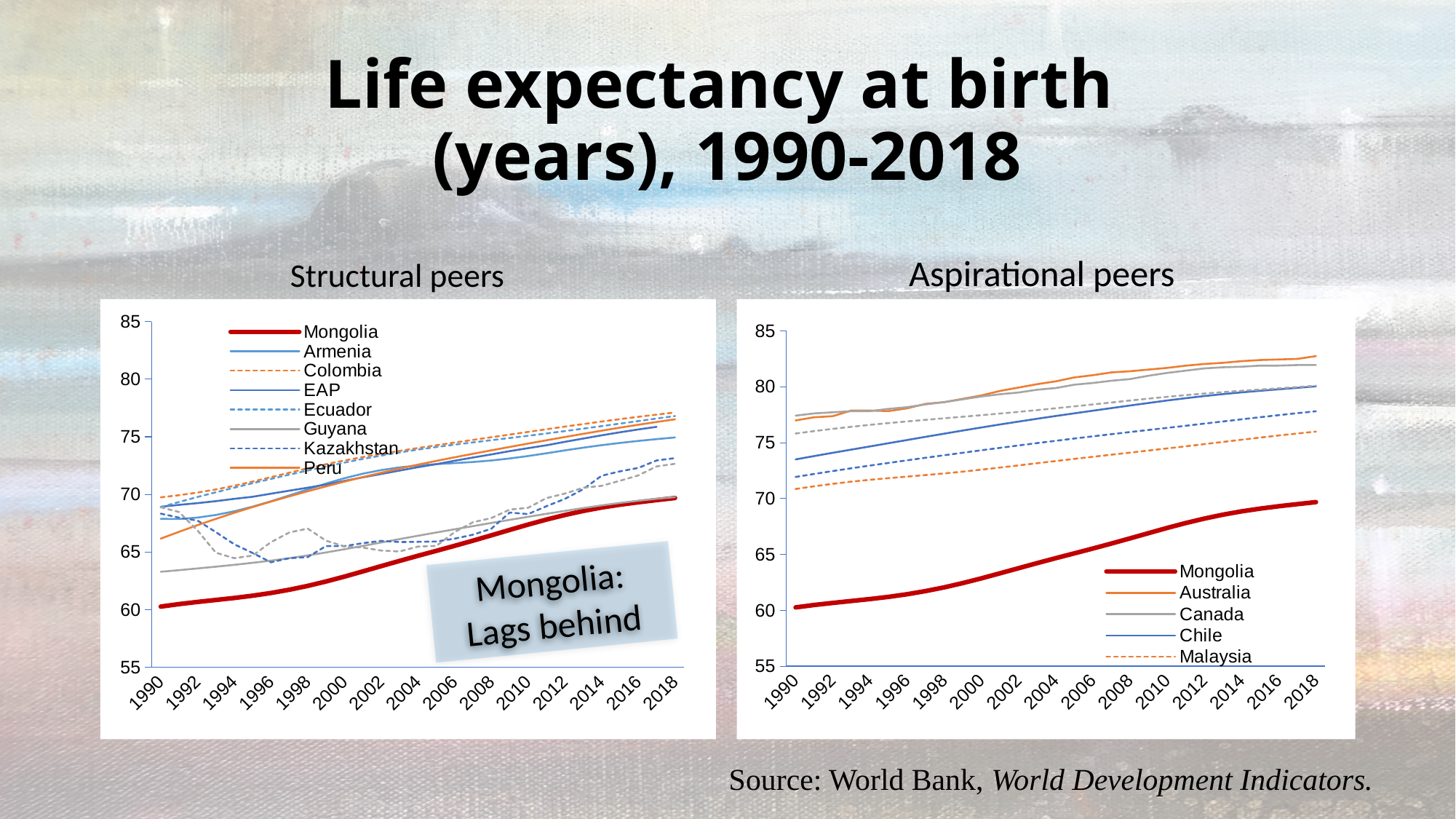
In the Structural peers chart, is the value for Mongolia in 1990 greater or less than 65? less In the Aspirational peers chart, does the value for Mongolia rise or fall from 1990 to 2018? rise In the Aspirational peers chart, which is larger in 2018, Australia or Mongolia? Australia How many series does the legend of the Aspirational peers chart list? 5 What does the annotation box on the Structural peers chart say? Mongolia: Lags behind In the Aspirational peers chart, which series has the lowest values throughout the period? Mongolia In the Aspirational peers chart, is the value for Chile in 1990 greater or less than 70? greater What kind of chart is the Structural peers chart? line chart In the Aspirational peers chart, is the value for Australia in 2018 greater or less than 80? greater How many series does the legend of the Structural peers chart list? 8 In the Structural peers chart, which is larger in 1990, Mongolia or Guyana? Guyana